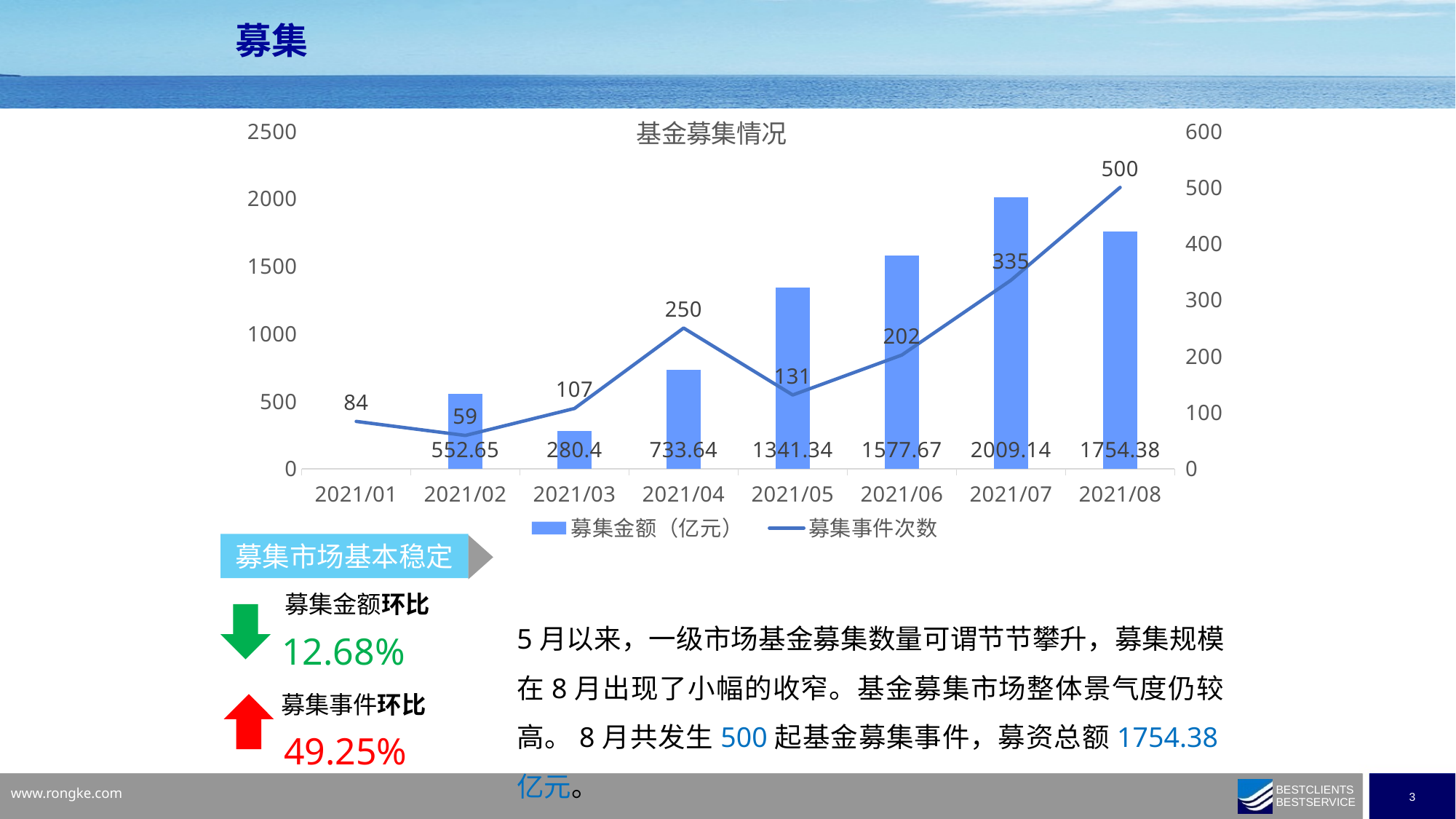
What is the difference in 募集金额（亿元） between 2021/07 and 2021/08? 254.76 What is the 募集金额（亿元） value for 2021/03? 280.4 What is the title of the chart? 基金募集情况 How many months are shown on the x axis of the chart? 8 How many series does the chart legend list? 2 What is the difference in 募集事件次数 between 2021/08 and 2021/07? 165 Which month has the highest 募集金额（亿元）? 2021/07 Which is larger, the 募集金额（亿元） for 2021/05 or for 2021/06? 2021/06 Which month has the highest 募集事件次数? 2021/08 What is the 募集事件次数 value for 2021/04? 250 What is the 募集金额（亿元） value for 2021/07? 2009.14 Which month has the lowest 募集事件次数? 2021/02